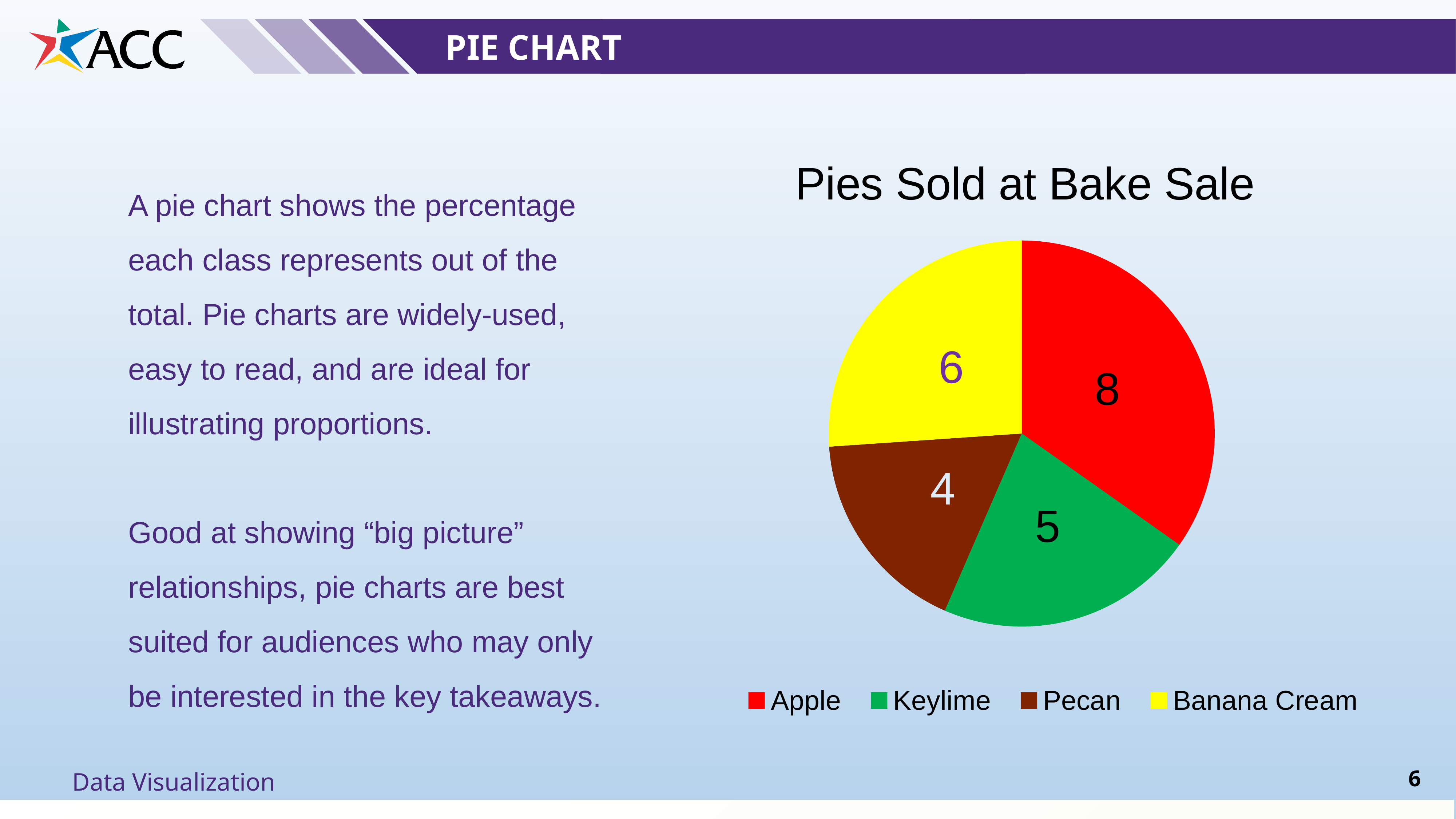
How many categories does the pie chart have? 4 What value is shown for Banana Cream? 6 What is the difference between the Apple and Pecan values? 4 Which pie type has the smallest slice? Pecan How many pies sold does the Apple slice show? 8 Which pie type has the largest slice? Apple What value is shown for Pecan? 4 What is the title of the chart? Pies Sold at Bake Sale What type of chart is shown on the slide? pie chart What value is shown for Keylime? 5 What is the total of all the slices in the pie chart? 23 Which is larger, the Banana Cream slice or the Keylime slice? Banana Cream